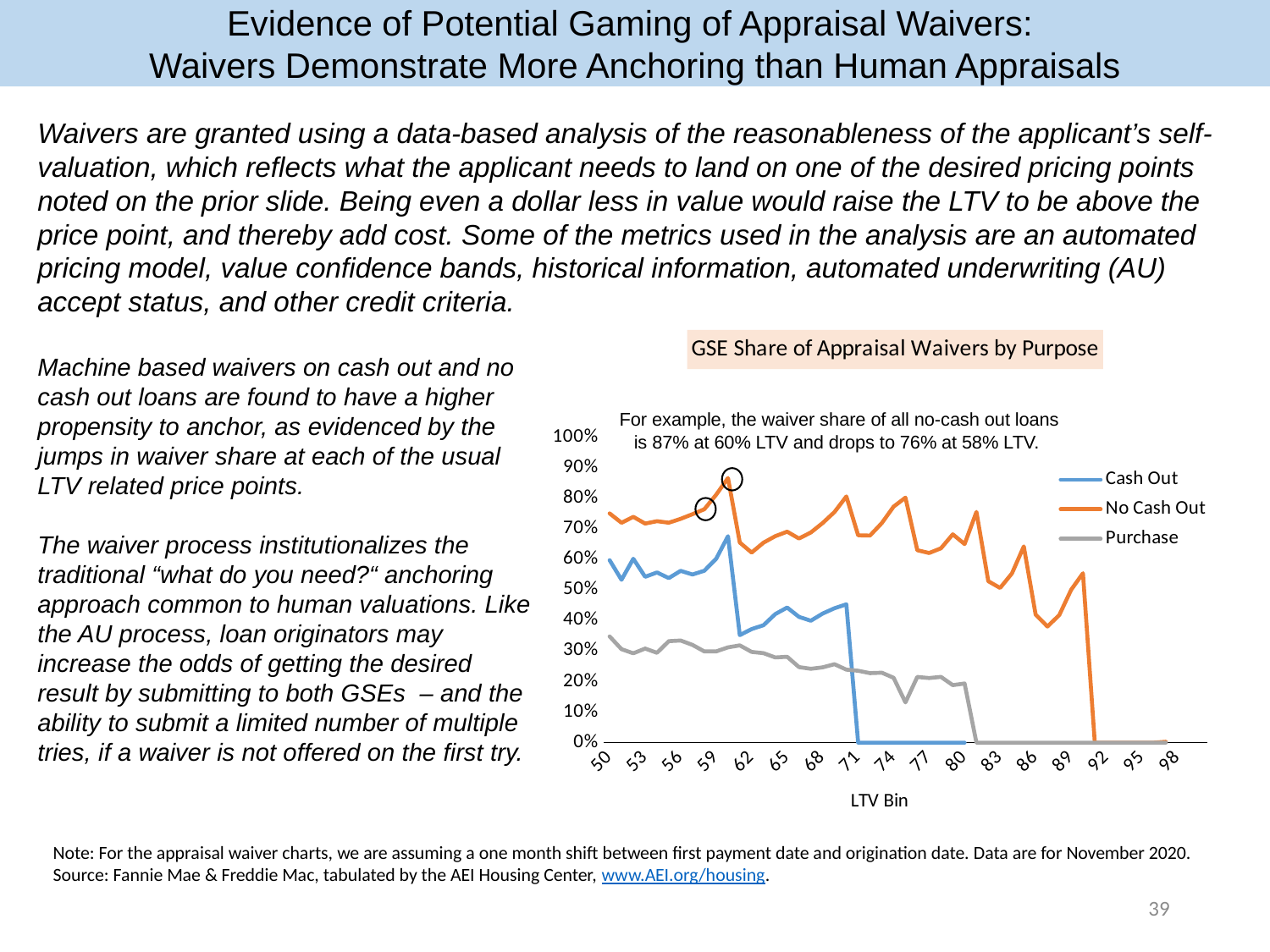
What is the title of the chart on the slide? GSE Share of Appraisal Waivers by Purpose At LTV bin 65, which series has the highest waiver share? No Cash Out At LTV bin 50, which is larger: the Cash Out share or the Purchase share? Cash Out Is the Cash Out waiver share at LTV bin 77 greater or less than 10%? less How many series does the chart's legend list? 3 What is the label of the x axis of the chart? LTV Bin Is the Cash Out waiver share at LTV bin 50 greater or less than 50%? greater By how many percentage points does the No Cash Out waiver share differ between 60% LTV and 58% LTV, per the annotation? 11 percentage points What kind of chart is shown on the slide? line chart According to the chart annotation, what is the waiver share of no-cash out loans at 60% LTV? 87% Is the Purchase waiver share at LTV bin 50 greater or less than 20%? greater According to the chart annotation, what is the waiver share of no-cash out loans at 58% LTV? 76%